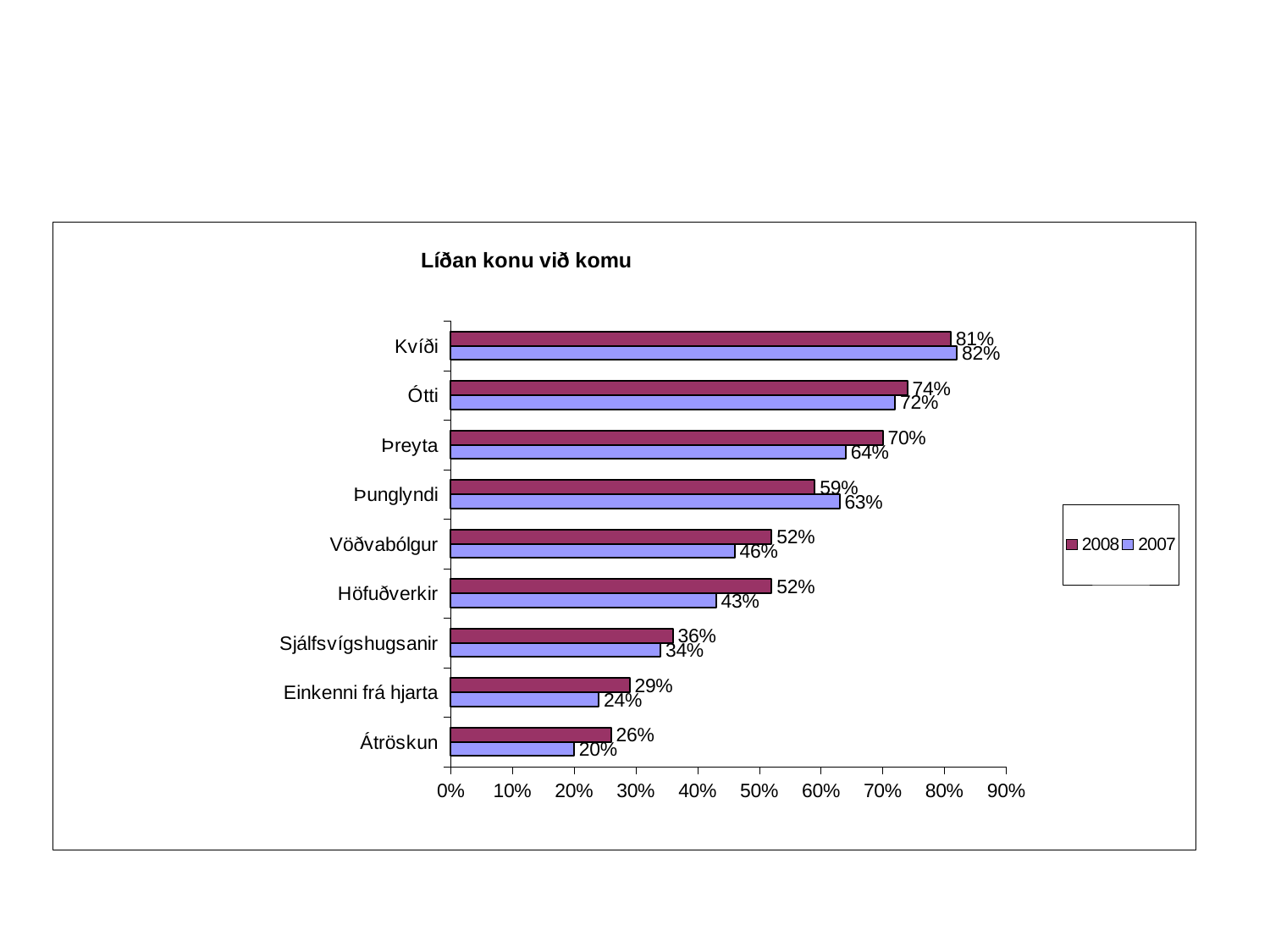
What is the 2007 value for Höfuðverkir? 43% What is the difference between the 2008 and 2007 values for Átröskun? 6% What is the difference between the 2008 and 2007 values for Höfuðverkir? 9% Which category has the highest 2008 value? Kvíði For Þunglyndi, which year has the larger value, 2008 or 2007? 2007 What is the 2008 value for Þreyta? 70% What is the 2007 value for Kvíði? 82% Which category has the lowest 2007 value? Átröskun What kind of chart is shown on the slide? Bar chart What is the title of the chart? Líðan konu við komu How many categories are shown on the chart? 9 How many series does the legend list? 2